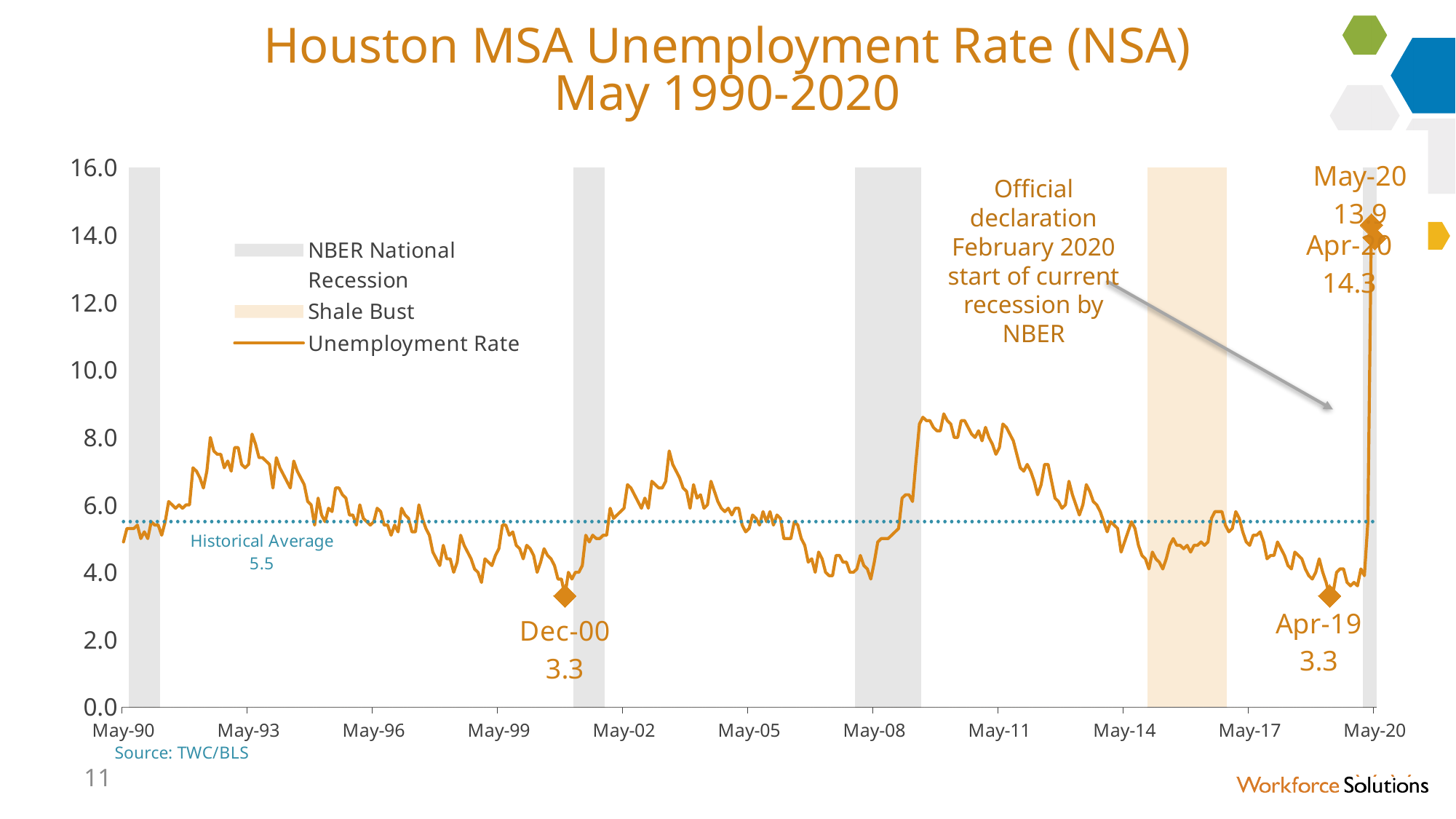
Which labeled point is higher, Apr-20 or May-20? Apr-20 What is the unemployment rate labeled for Apr-20? 14.3 What is the unemployment rate labeled for May-20? 13.9 What is the historical average unemployment rate shown by the dotted line? 5.5 Is the unemployment rate in May-20 greater or less than 12.0? greater What is the unemployment rate labeled for Dec-00? 3.3 Is the unemployment rate in Apr-19 greater or less than 4.0? less What is the difference between the labeled Apr-20 and May-20 unemployment rates? 0.4 What is the unemployment rate labeled for Apr-19? 3.3 How many entries does the legend list? 3 What kind of chart is shown on the slide? line chart What is the source cited for the chart data? TWC/BLS